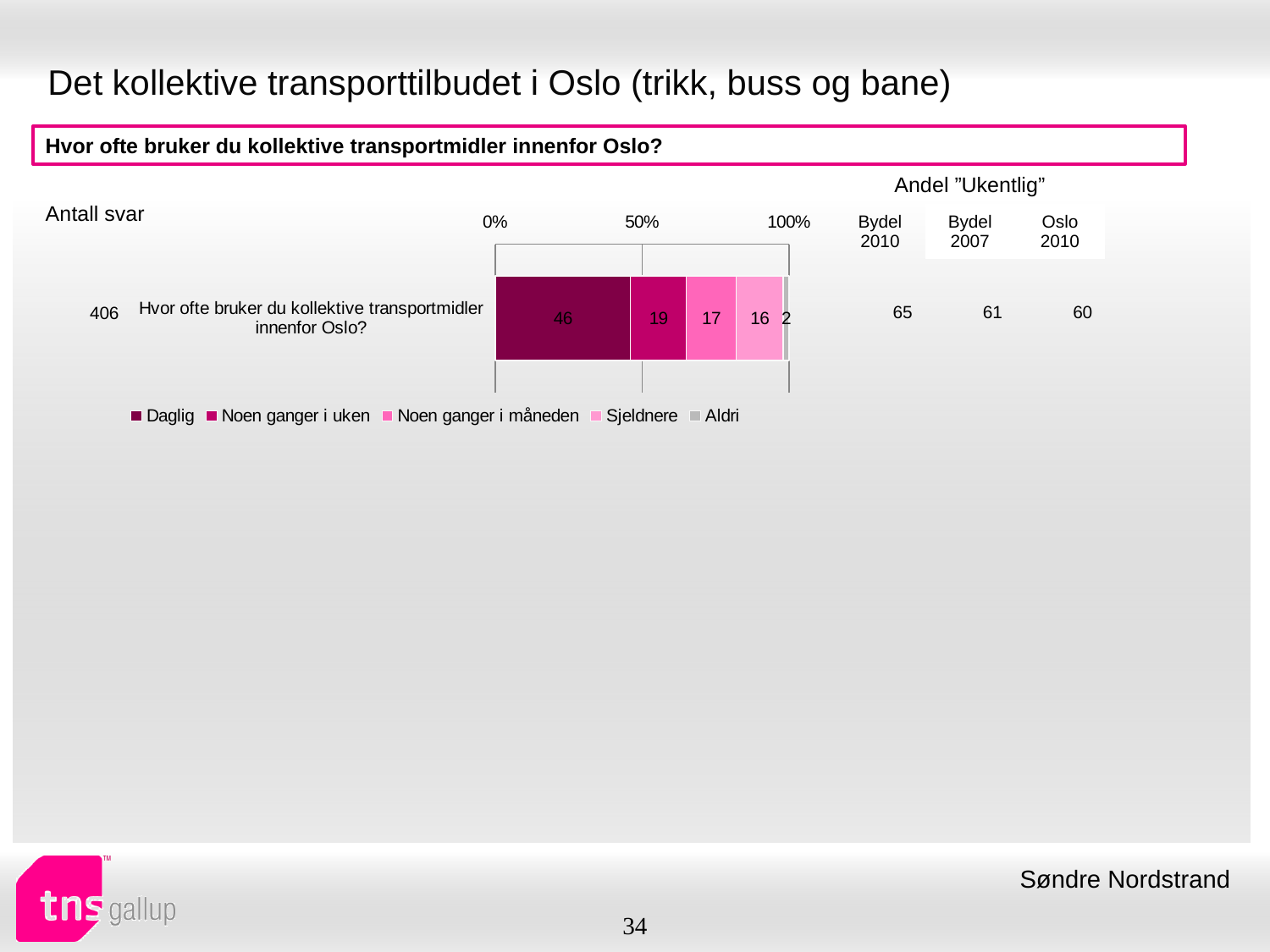
What value is shown for the "Noen ganger i uken" segment? 19 Which is larger, the "Noen ganger i måneden" segment or the "Sjeldnere" segment? Noen ganger i måneden What value is shown for the "Daglig" segment of the bar? 46 What value is shown for the "Sjeldnere" segment? 16 What kind of chart is shown? Stacked bar chart What value is shown for the "Aldri" segment? 2 How many series does the legend list? 5 Which legend category has the smallest segment in the bar? Aldri What is the difference between the "Daglig" and "Noen ganger i uken" values? 27 Which legend category has the largest segment in the bar? Daglig What is the total of all segments in the stacked bar? 100 What is the "Antall svar" (number of responses) shown for the question? 406